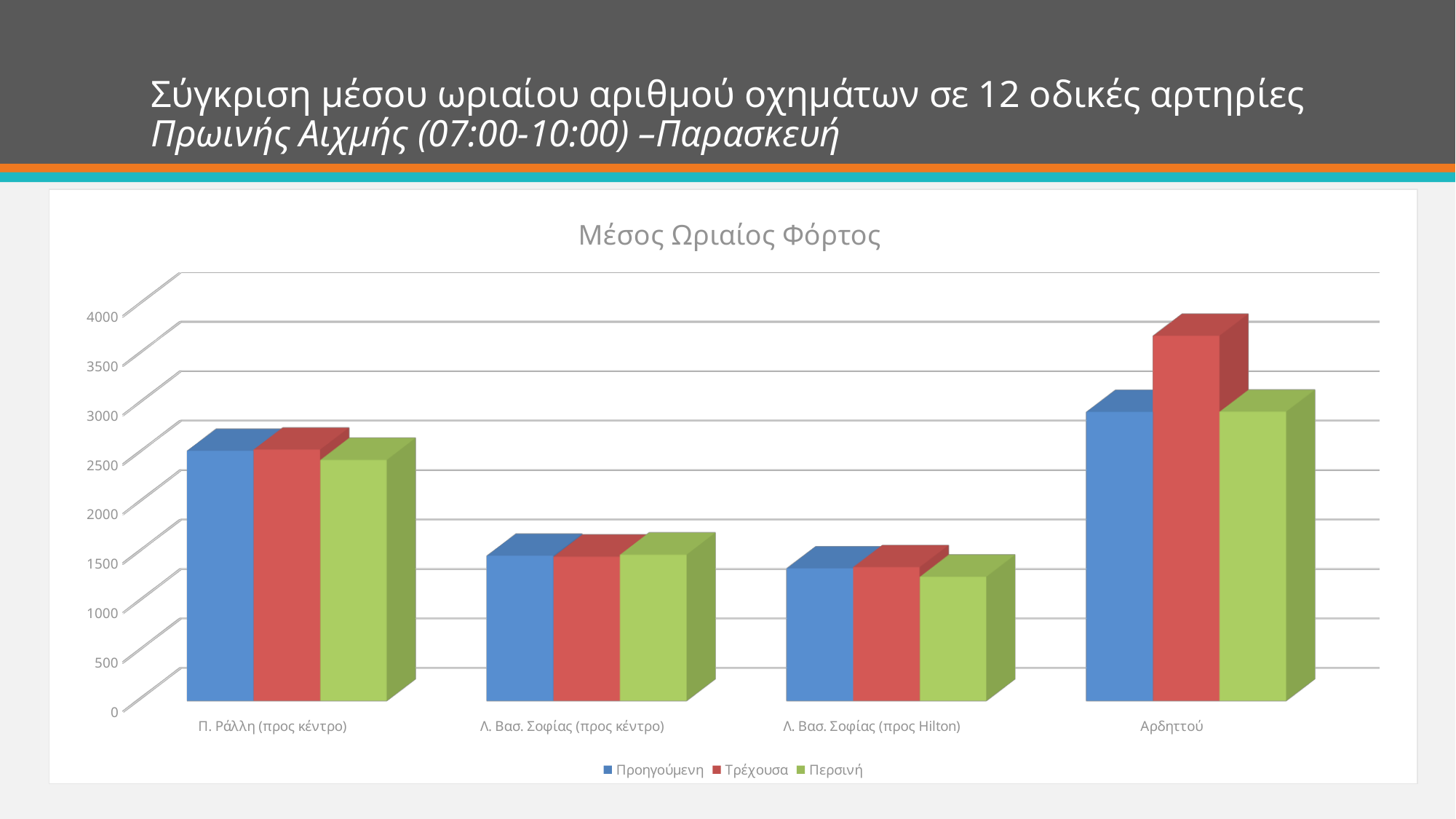
Which category has the highest value for the Τρέχουσα series? Αρδηττού What kind of chart is shown on the slide? bar chart How many series does the chart legend list? 3 For the Προηγούμενη series, which is larger: Π. Ράλλη (προς κέντρο) or Λ. Βασ. Σοφίας (προς κέντρο)? Π. Ράλλη (προς κέντρο) Which series is shown in red in the chart? Τρέχουσα Is the Περσινή value for Λ. Βασ. Σοφίας (προς Hilton) greater or less than 2000? less Is the Τρέχουσα value for Αρδηττού greater or less than 3000? greater What is the title of the chart? Μέσος Ωριαίος Φόρτος Which category has the lowest value for the Περσινή series? Λ. Βασ. Σοφίας (προς Hilton) How many road categories are shown on the x axis of the chart? 4 For Αρδηττού, which is larger: the Τρέχουσα value or the Προηγούμενη value? Τρέχουσα Is the Προηγούμενη value for Π. Ράλλη (προς κέντρο) greater or less than 2000? greater